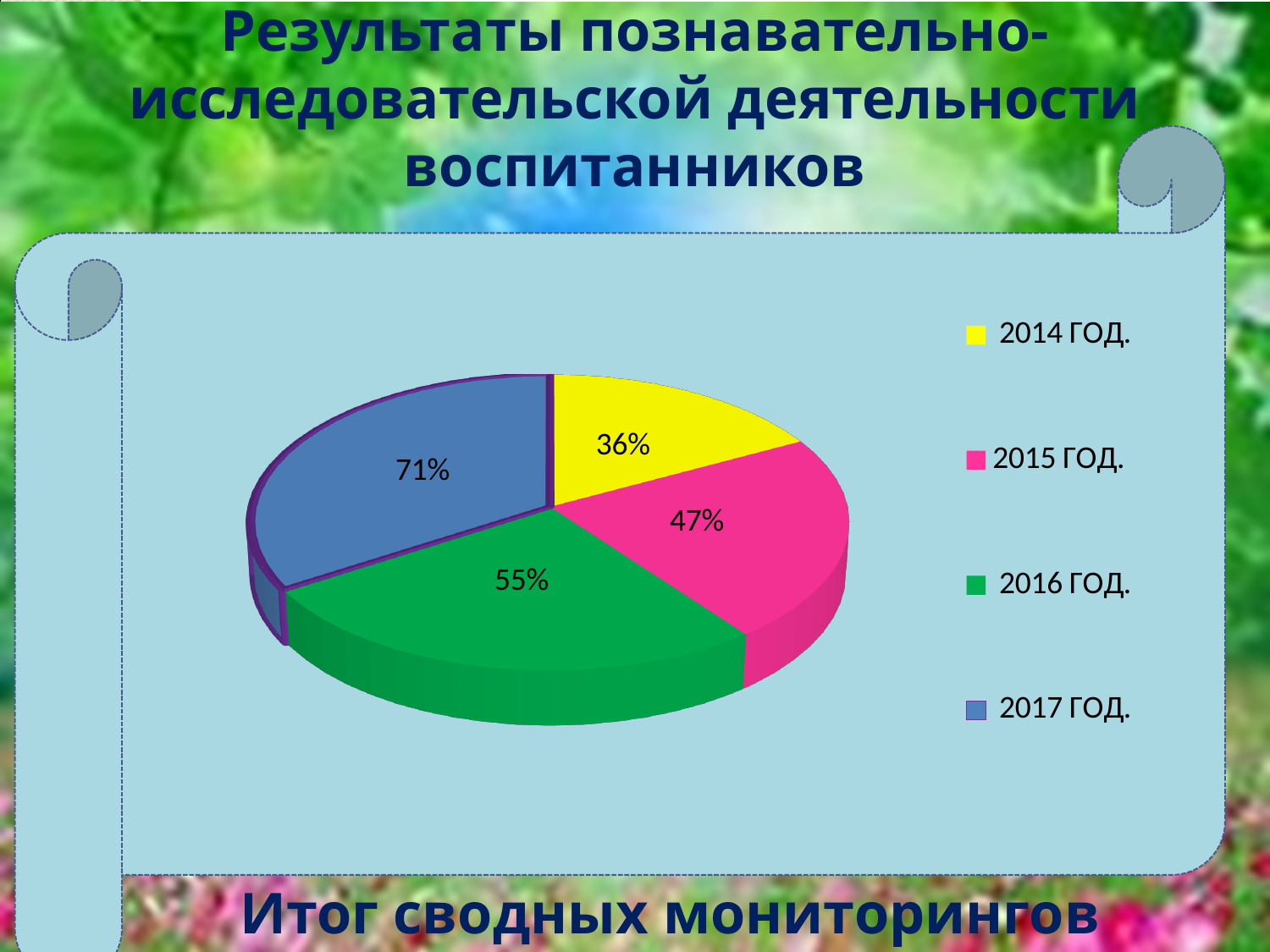
Which year has the largest slice in the pie chart? 2017 ГОД. What value is labelled on the slice for 2014 ГОД.? 36% What value is labelled on the slice for 2015 ГОД.? 47% Which colour represents 2016 ГОД. in the legend? green What kind of chart is shown on the slide? pie chart Which is larger, the value for 2015 ГОД. or the value for 2016 ГОД.? 2016 ГОД. What is the difference between the labelled values for 2017 ГОД. and 2014 ГОД.? 35% What is the difference between the labelled values for 2016 ГОД. and 2015 ГОД.? 8% How many slices does the pie chart have? 4 What value is labelled on the slice for 2017 ГОД.? 71% Which year has the smallest slice in the pie chart? 2014 ГОД. What value is labelled on the slice for 2016 ГОД.? 55%